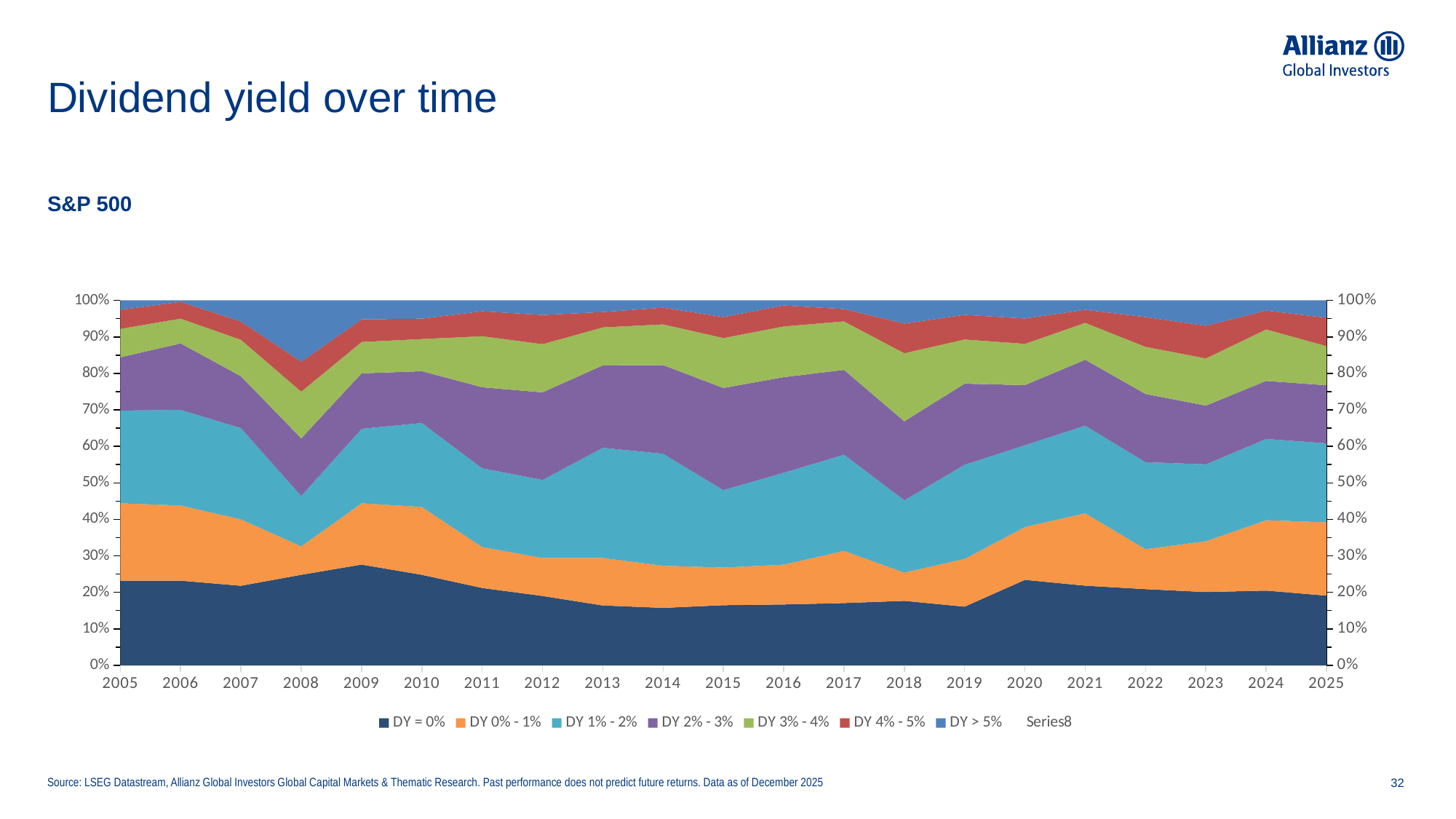
Is the value for DY = 0% in 2019 greater or less than 20%? less Is the value for DY = 0% in 2005 greater or less than 20%? greater How many years are plotted along the x axis of the chart? 21 How many series does the chart's legend list? 8 In which year is the DY = 0% share highest? 2009 Does the DY = 0% share rise or fall from 2009 to 2014? Fall Is the value for DY = 0% in 2009 greater or less than 20%? greater What is the first series listed in the chart's legend? DY = 0% Which is larger, the DY = 0% share in 2009 or in 2019? 2009 What kind of chart is shown on the slide? Stacked area chart Which index does the chart cover, according to the subtitle above it? S&P 500